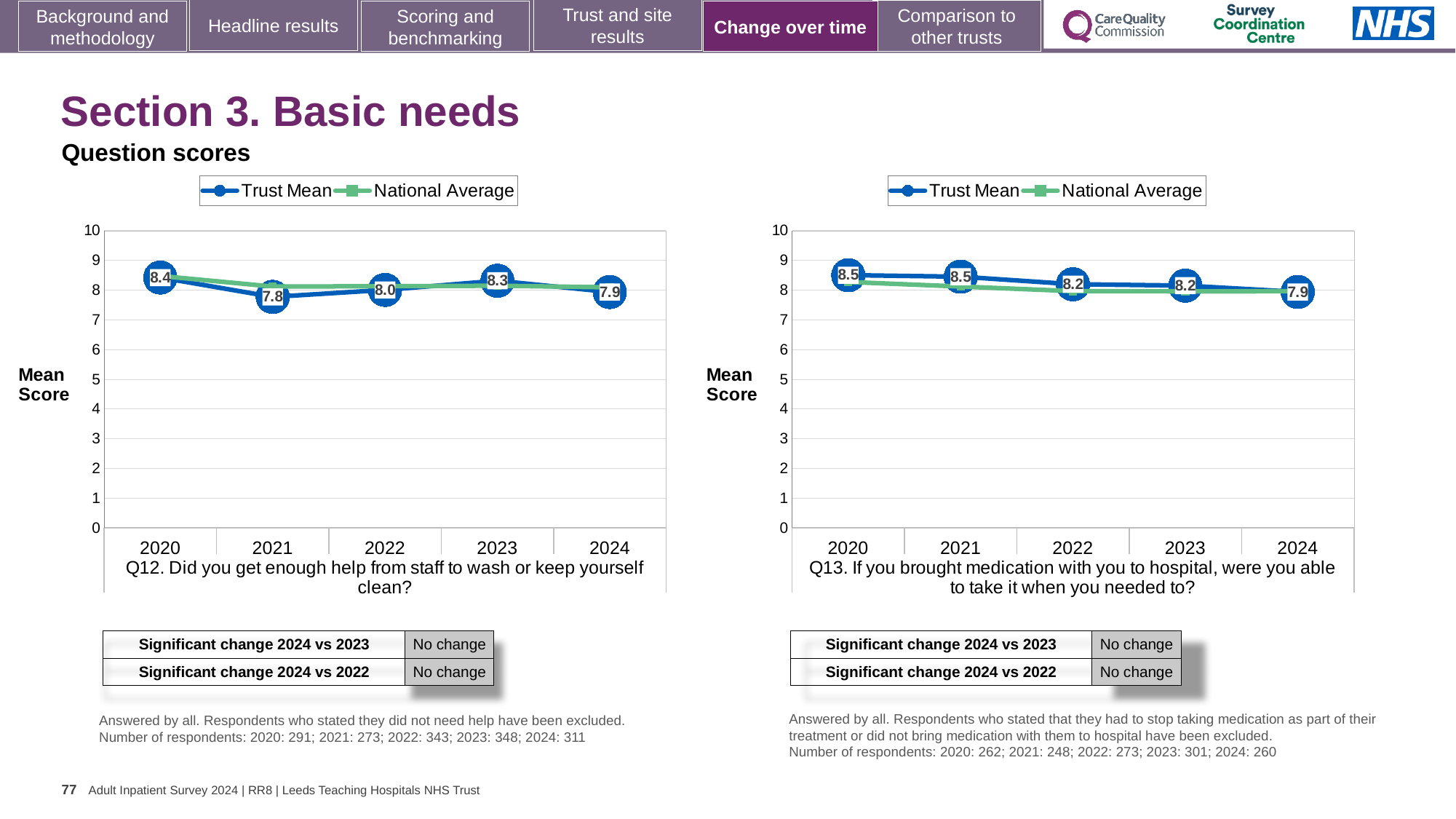
On the Q13 chart (right), what is the difference between the Trust Mean for 2020 and 2024? 0.6 On the Q12 chart (left), which year has the highest Trust Mean? 2020 On the Q12 chart (left), what is the Trust Mean for 2020? 8.4 On the Q13 chart (right), is the Trust Mean for 2020 greater or less than the Trust Mean for 2022? greater How many series does the legend list on the Q12 chart (left)? 2 On the Q13 chart (right), which year has the lowest Trust Mean? 2024 On the Q12 chart (left), what is the difference between the Trust Mean for 2023 and 2024? 0.4 What type of chart is the Q13 chart (right)? Line chart On the Q13 chart (right), what is the Trust Mean for 2024? 7.9 On the Q12 chart (left), what is the Trust Mean for 2021? 7.8 On the Q12 chart (left), which year has the lowest Trust Mean? 2021 On the Q13 chart (right), what is the Trust Mean for 2022? 8.2